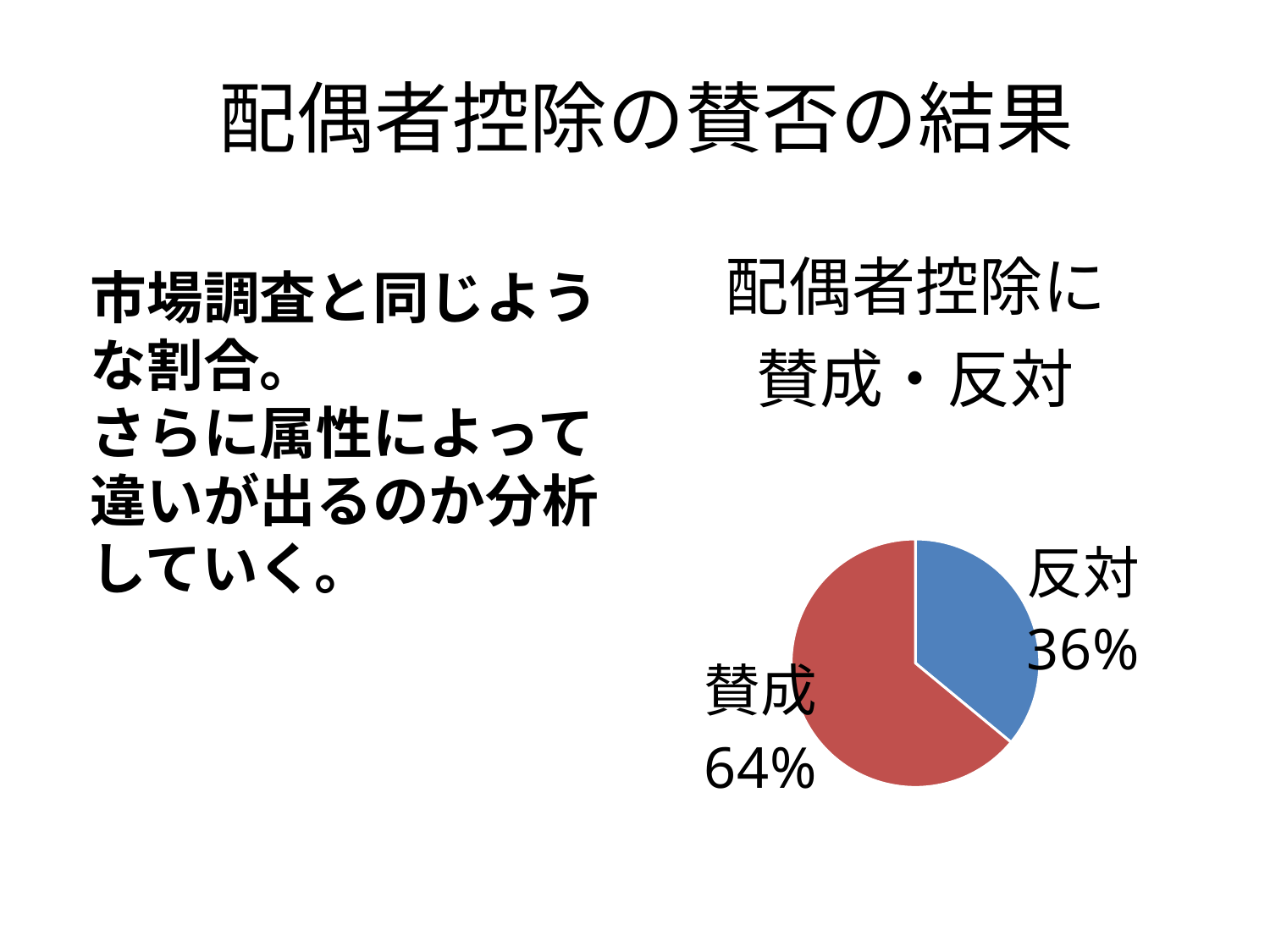
What colour is the 賛成 slice? red Which slice of the pie is the largest? 賛成 What share of the pie does 反対 represent? 36% What percentage of the pie is 賛成? 64% What is the difference in percentage points between 賛成 and 反対? 28 What kind of chart is shown on the slide? pie chart Which is larger, the 賛成 slice or the 反対 slice? 賛成 What percentage of the pie is 反対? 36% What is the title of the chart? 配偶者控除に賛成・反対 How many slices does the pie chart have? 2 Which slice of the pie is the smallest? 反対